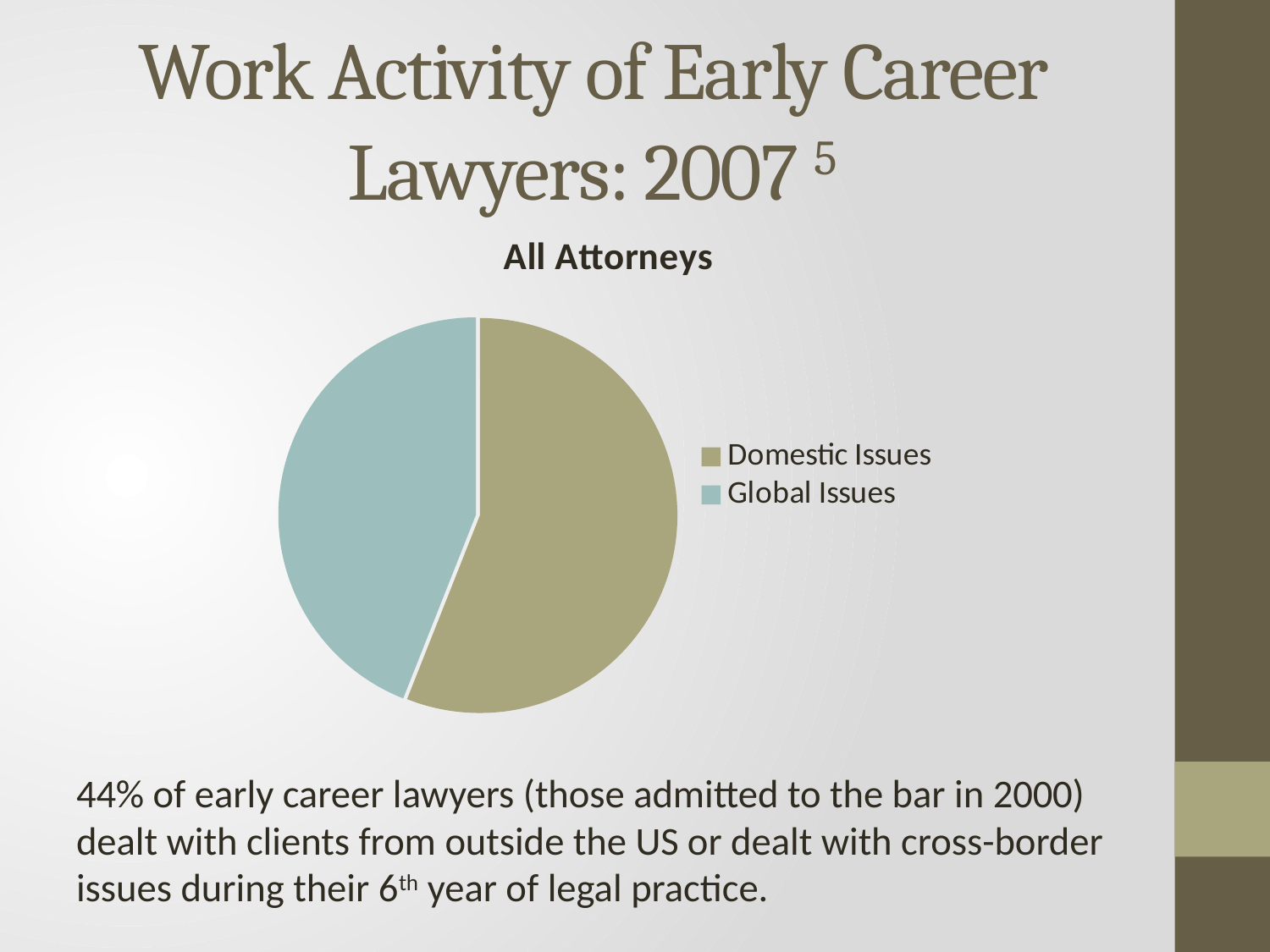
How many entries does the chart legend list? 2 Which slice of the pie chart is the smallest? Global Issues Which slice is larger, Domestic Issues or Global Issues? Domestic Issues Which slice of the pie chart is the largest? Domestic Issues How many slices does the pie chart have? 2 What colour is the Global Issues slice in the pie chart? light blue What is the title of the chart? All Attorneys What kind of chart is shown on the slide? pie chart